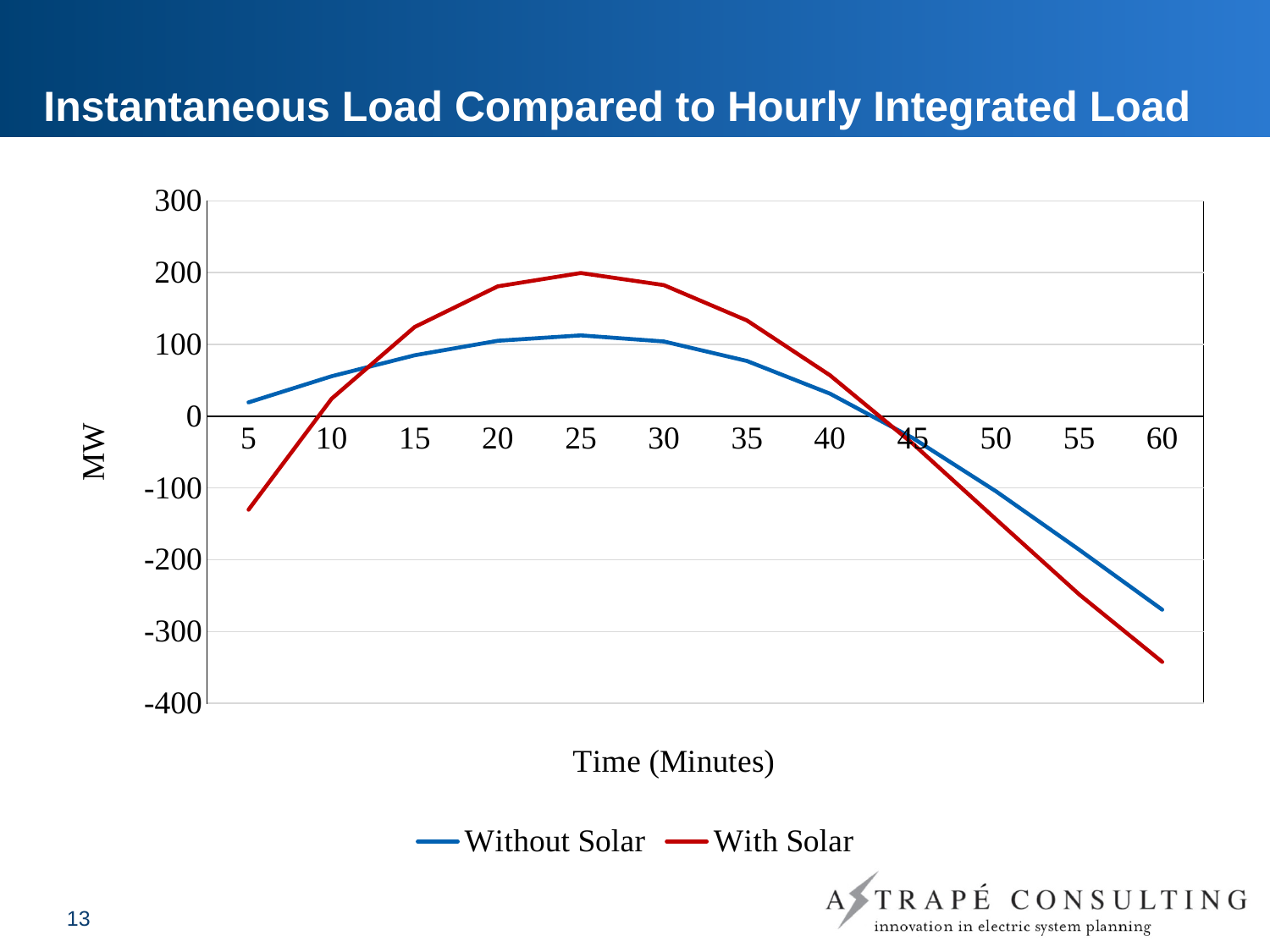
At 60 minutes, which series has the higher value, Without Solar or With Solar? Without Solar Do the With Solar values rise or fall between 25 and 60 minutes? fall Is the Without Solar value at 60 minutes greater or less than -300? greater At which time (minutes) does the With Solar line reach its highest value? 25 Is the With Solar value at 25 minutes greater or less than 100? greater Is the With Solar value at 5 minutes greater or less than -100? less How many time points are plotted along the x axis? 12 At 25 minutes, which series has the higher value, Without Solar or With Solar? With Solar At which time (minutes) does the With Solar line reach its lowest value? 60 How many series does the legend list? 2 What kind of chart is shown on the slide? line chart